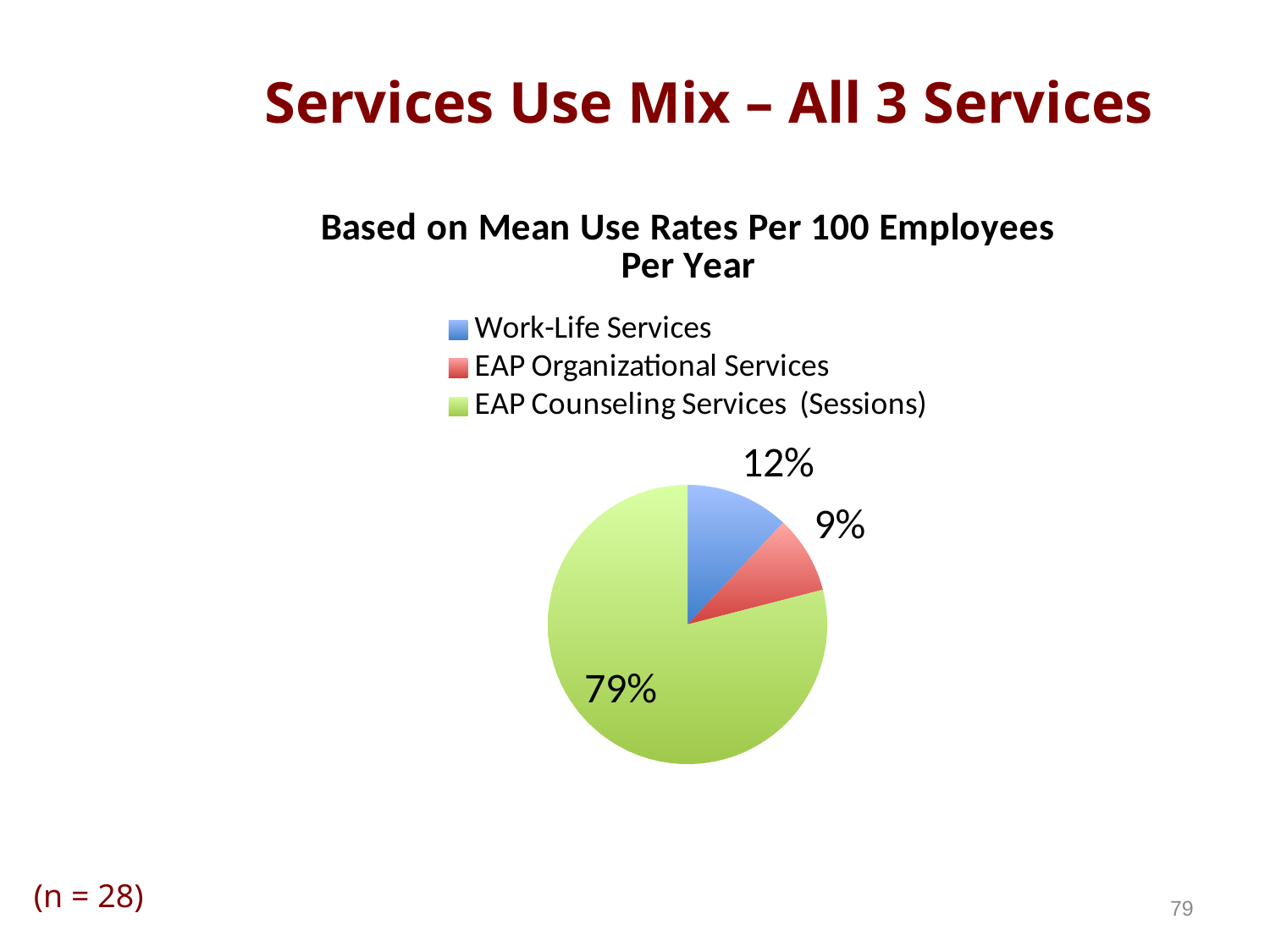
What share of the pie is EAP Counseling Services (Sessions)? 79% Which is larger, the Work-Life Services slice or the EAP Organizational Services slice? Work-Life Services How many slices does the pie chart have? 3 Which service has the smallest slice of the pie? EAP Organizational Services What is the difference in percentage points between Work-Life Services and EAP Organizational Services? 3 What kind of chart is shown on the slide? Pie chart How many entries does the legend list? 3 Which service has the largest slice of the pie? EAP Counseling Services (Sessions) What share of the pie is Work-Life Services? 12% What colour is the EAP Counseling Services (Sessions) slice? Green What is the difference in percentage points between EAP Counseling Services (Sessions) and Work-Life Services? 67 What share of the pie is EAP Organizational Services? 9%